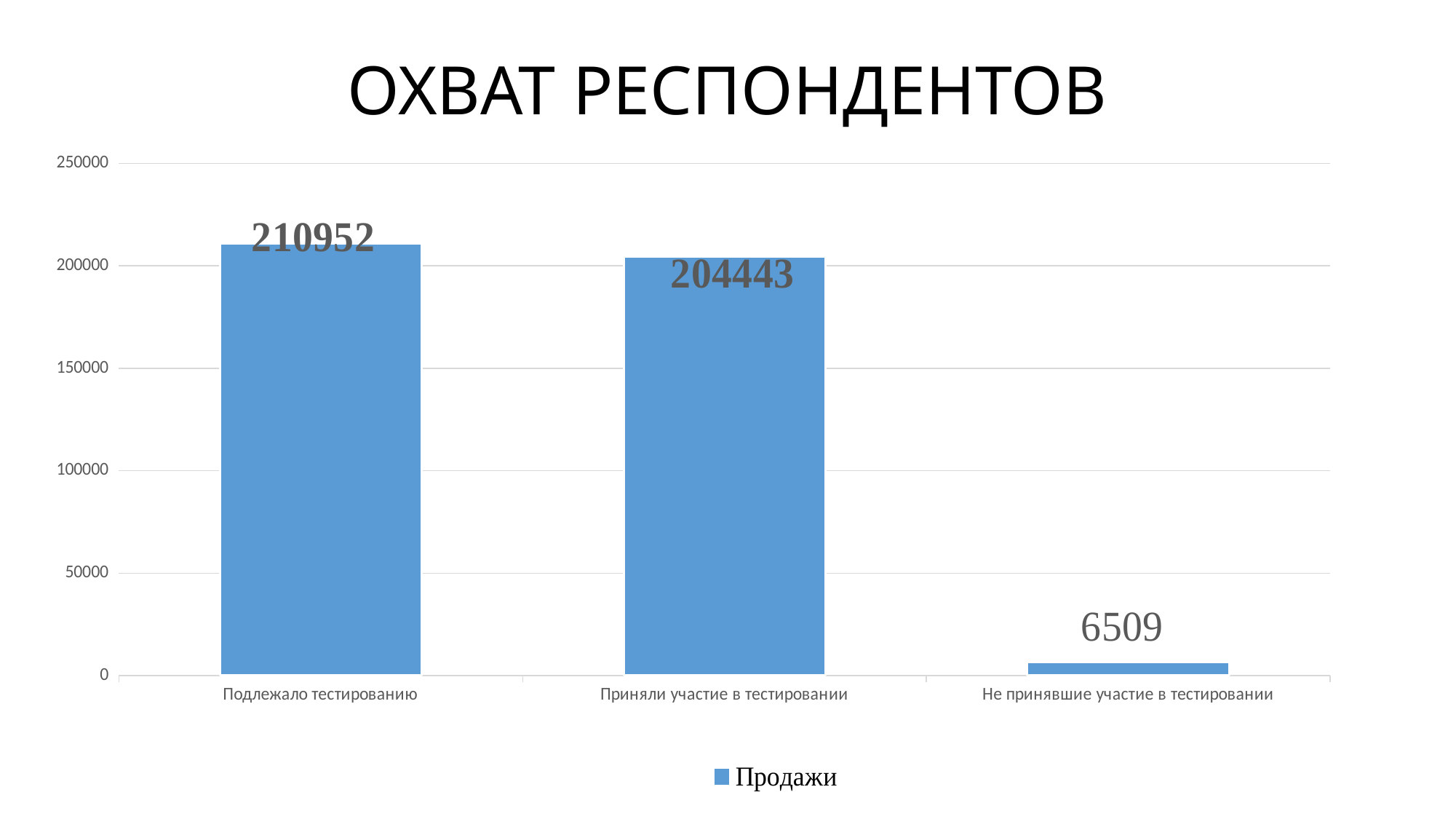
Which category has the highest value? Подлежало тестированию Which is larger: the value for "Приняли участие в тестировании" or the value for "Не принявшие участие в тестировании"? Приняли участие в тестировании Is the value for "Приняли участие в тестировании" greater or less than 200000? greater How many series does the legend list? 1 What is the title of the chart? ОХВАТ РЕСПОНДЕНТОВ What is the difference between the values for "Подлежало тестированию" and "Приняли участие в тестировании"? 6509 What is the value for "Приняли участие в тестировании"? 204443 What is the value for "Подлежало тестированию"? 210952 How many categories are shown on the x axis? 3 Which category has the lowest value? Не принявшие участие в тестировании What is the value for "Не принявшие участие в тестировании"? 6509 What kind of chart is shown on the slide? bar chart